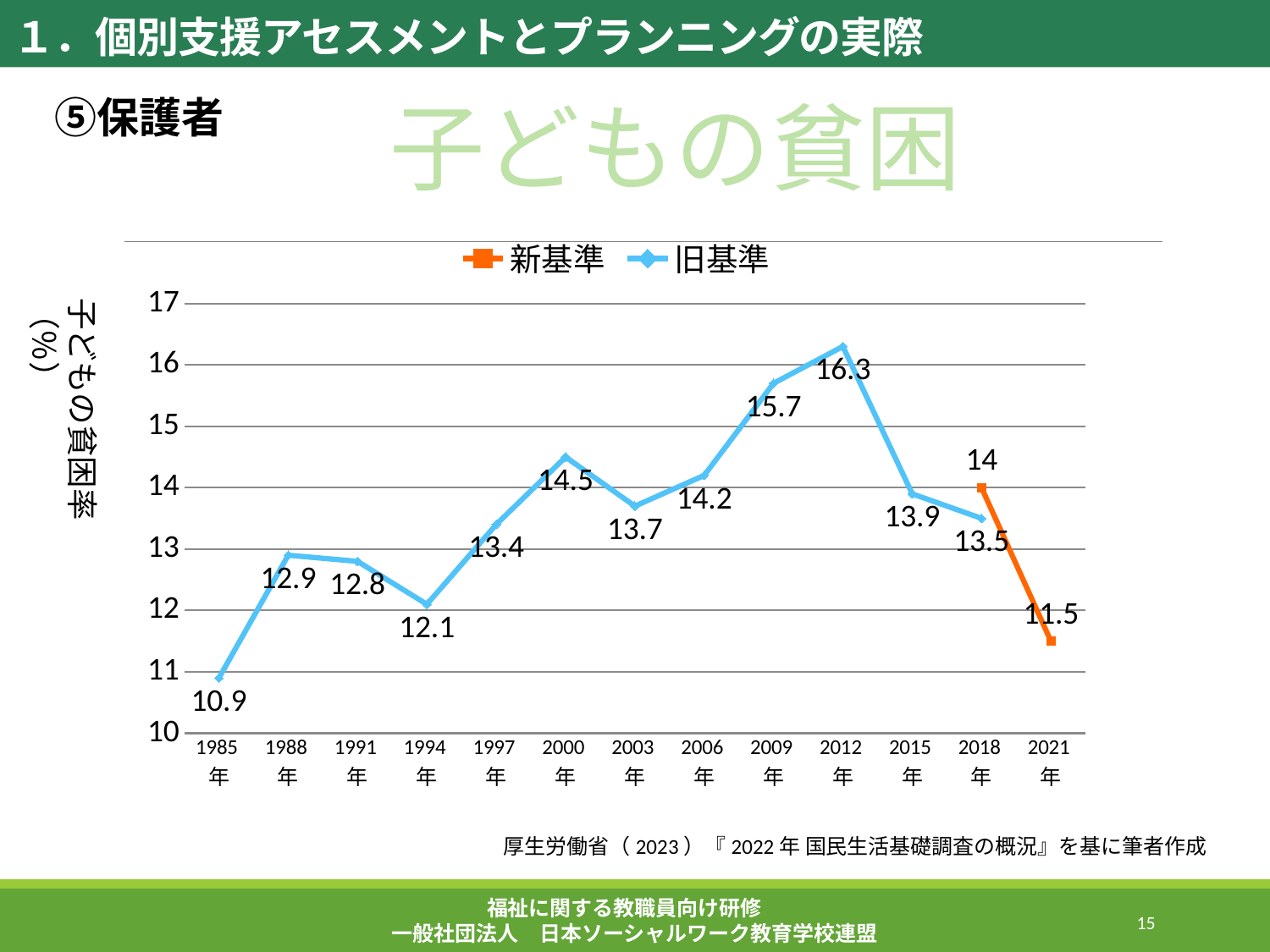
Which year has the lowest 旧基準 value? 1985年 Which year has the highest 旧基準 value? 2012年 What is the 新基準 value for 2021年? 11.5 What type of chart is shown on the slide? line chart What is the difference between the 旧基準 values for 2012年 and 2015年? 2.4 How many series does the legend list? 2 How many years are shown on the x axis? 13 What is the 旧基準 value for 2012年? 16.3 What is the 旧基準 value for 1985年? 10.9 What is the 新基準 value for 2018年? 14 Which is larger, the 旧基準 value for 2000年 or for 2006年? 2000年 Does the 新基準 line rise or fall from 2018年 to 2021年? fall